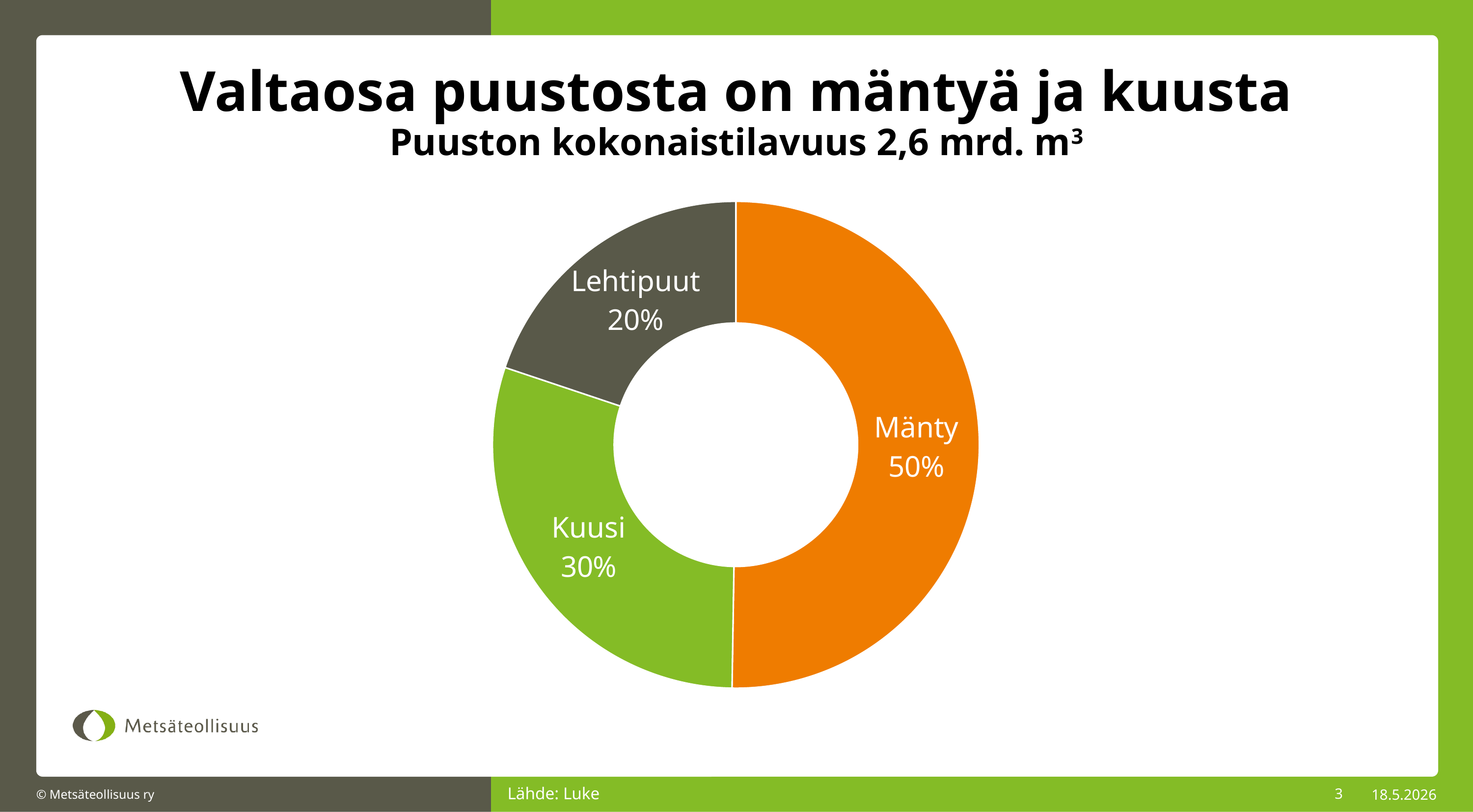
What share of the total does Mänty have? 50% What kind of chart is shown on the slide? Pie chart (doughnut) What is the difference in percentage points between Kuusi and Lehtipuut? 10 How many categories does the chart show? 3 What colour is the Mänty slice? Orange What is the difference in percentage points between Mänty and Kuusi? 20 Which category has the largest share? Mänty What share of the total does Kuusi have? 30% What share of the total does Lehtipuut have? 20% Which is larger, the share for Kuusi or the share for Lehtipuut? Kuusi Which category has the smallest share? Lehtipuut What is the combined share of Mänty and Kuusi? 80%